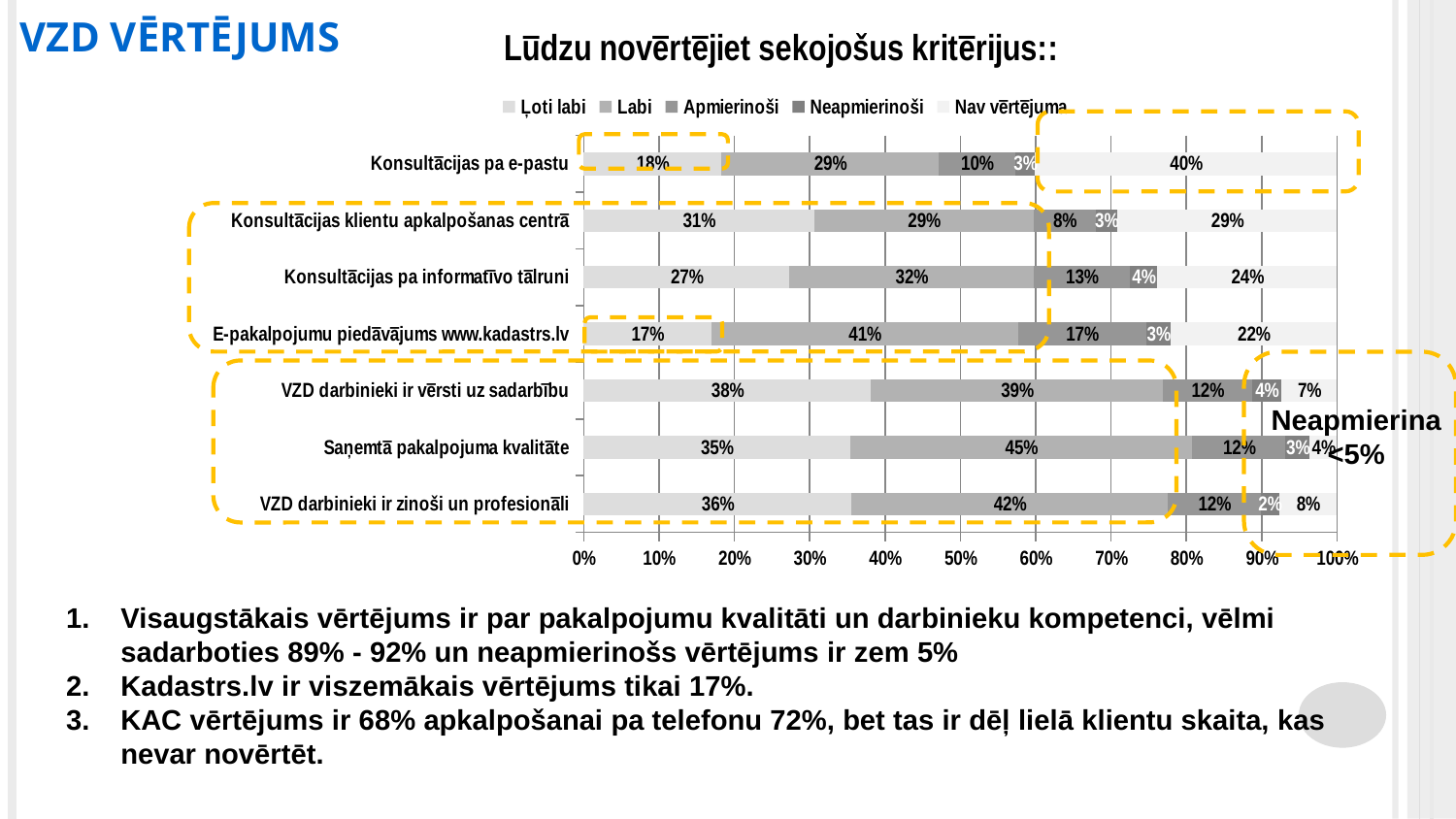
What is the "Labi" value for "Saņemtā pakalpojuma kvalitāte"? 45% How many series does the legend list? 5 What is the "Nav vērtējuma" value for "Konsultācijas pa e-pastu"? 40% What is the title of the chart? Lūdzu novērtējiet sekojošus kritērijus:: Which category has the lowest "Nav vērtējuma" value? Saņemtā pakalpojuma kvalitāte How many categories are plotted on the chart? 7 What is the "Ļoti labi" value for "VZD darbinieki ir vērsti uz sadarbību"? 38% What is the difference between the "Ļoti labi" values for "Konsultācijas klientu apkalpošanas centrā" and "Konsultācijas pa informatīvo tālruni"? 4% Which is larger: the "Labi" value for "E-pakalpojumu piedāvājums www.kadastrs.lv" or the "Labi" value for "Konsultācijas pa informatīvo tālruni"? E-pakalpojumu piedāvājums www.kadastrs.lv Which category has the highest "Labi" value? Saņemtā pakalpojuma kvalitāte What is the "Apmierinoši" value for "E-pakalpojumu piedāvājums www.kadastrs.lv"? 17% What type of chart is shown on the slide? bar chart